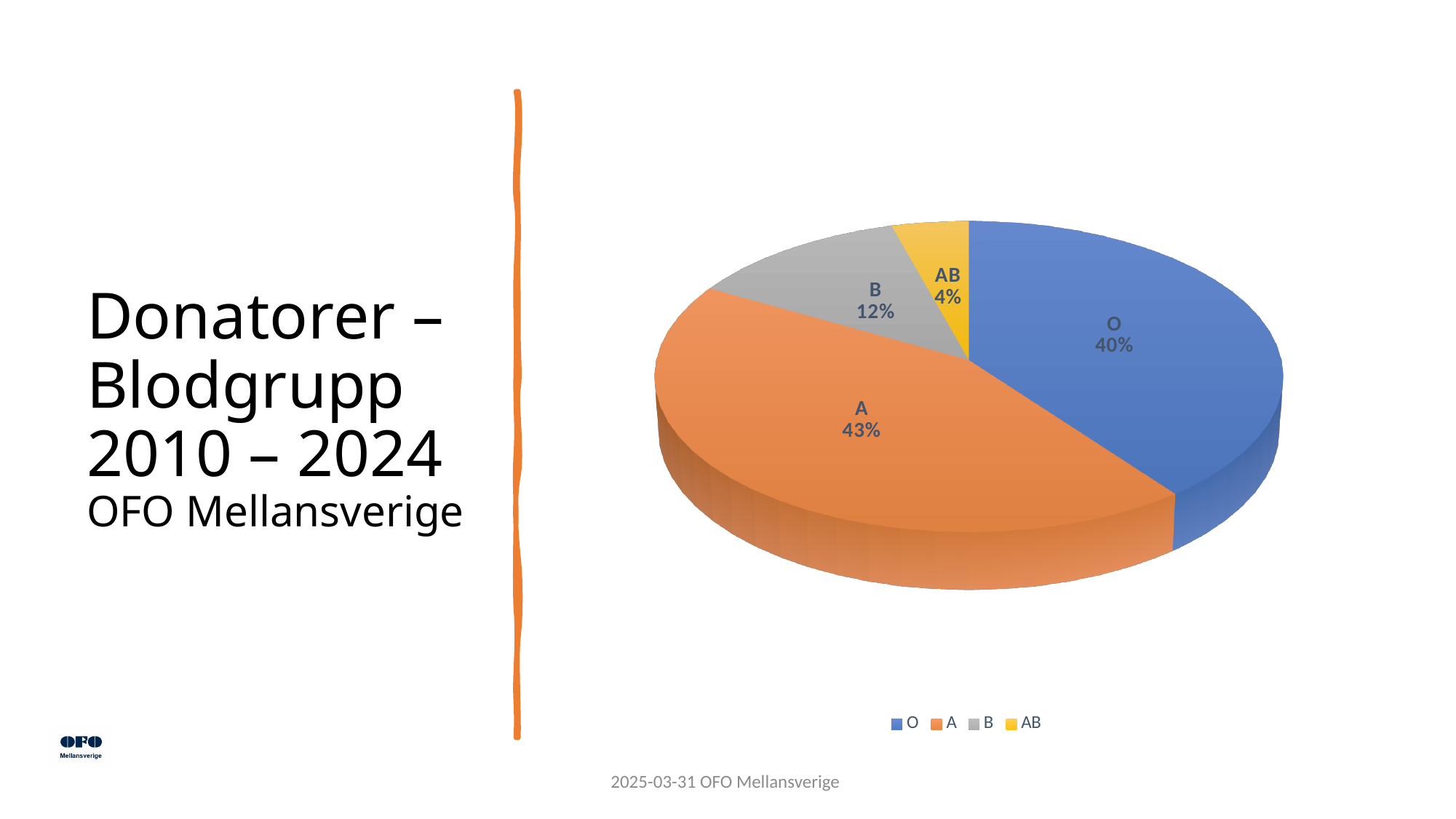
What share of donors has blood group AB? 4% What share of donors has blood group B? 12% Which blood group has the largest share of the pie? A What kind of chart is shown on the slide? pie chart Which blood group has the smallest share of the pie? AB What is the difference in percentage points between blood group B and blood group AB? 8 What share of donors has blood group A? 43% Which is larger, the share for blood group B or the share for blood group AB? B What is the difference in percentage points between blood group A and blood group O? 3 What share of donors has blood group O? 40% How many blood groups are shown in the pie chart? 4 What colour is the slice for blood group AB? yellow